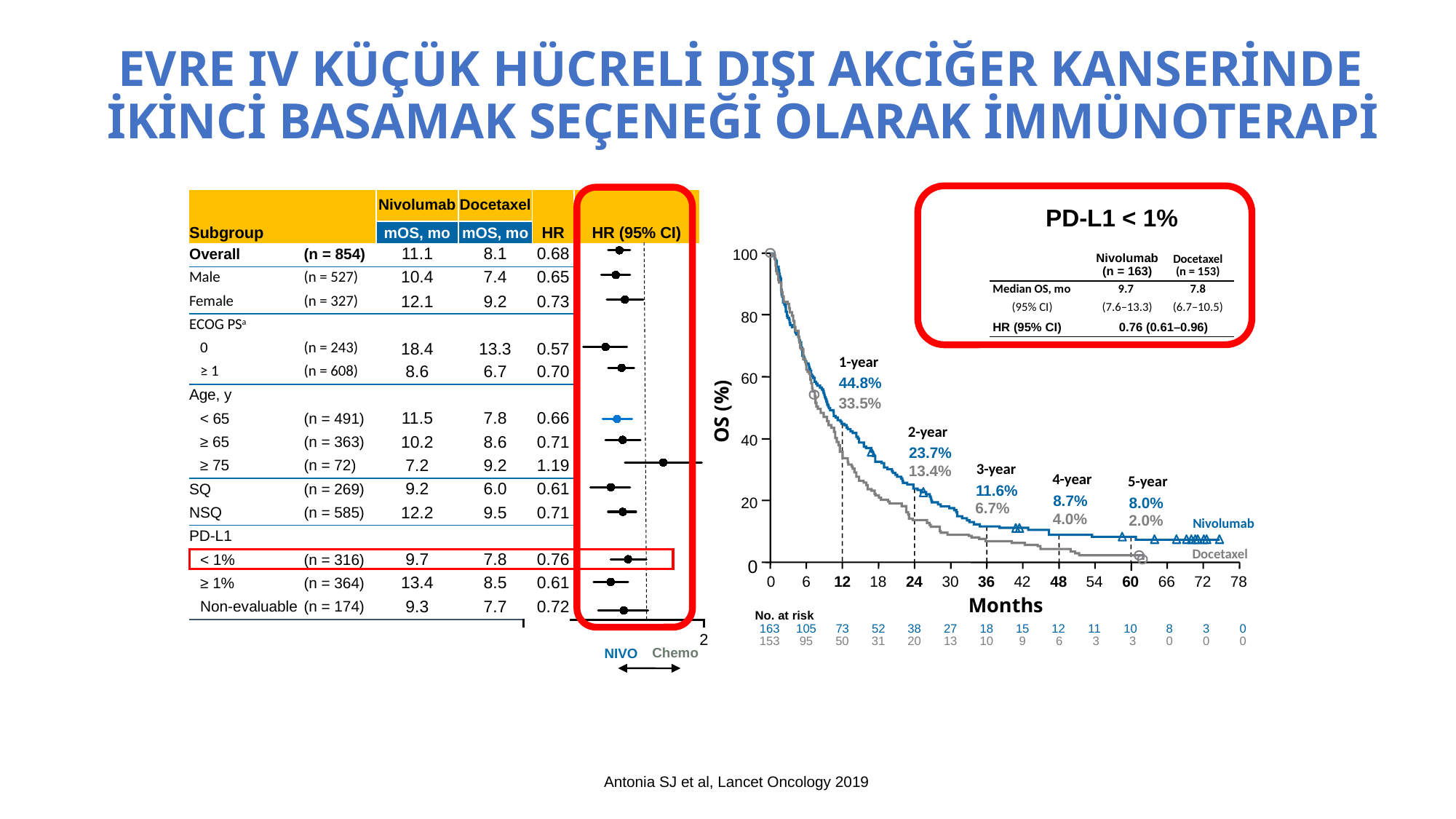
On the PD-L1 < 1% survival chart, what is the 1-year OS rate for Nivolumab? 44.8% On the PD-L1 < 1% survival chart, what is the 1-year OS rate for Docetaxel? 33.5% On the PD-L1 < 1% survival chart, what is the difference between the Nivolumab and Docetaxel 2-year OS rates? 10.3 percentage points On the PD-L1 < 1% survival chart, how many Docetaxel patients are at risk at 24 months? 20 On the PD-L1 < 1% survival chart, how many Nivolumab patients are at risk at 12 months? 73 In the forest plot on the left, what is the HR for the Overall subgroup? 0.68 On the PD-L1 < 1% survival chart, what is the 5-year OS rate for Nivolumab? 8.0% On the PD-L1 < 1% survival chart, how many treatment arms (series) are plotted? 2 What kind of chart is the PD-L1 < 1% OS chart on the right? line chart On the PD-L1 < 1% survival chart, do the OS curves rise or fall as months increase? fall In the forest plot on the left, which subgroup has the highest HR? ≥ 75 (Age, y) On the PD-L1 < 1% survival chart, which arm has the higher 3-year OS rate, Nivolumab or Docetaxel? Nivolumab